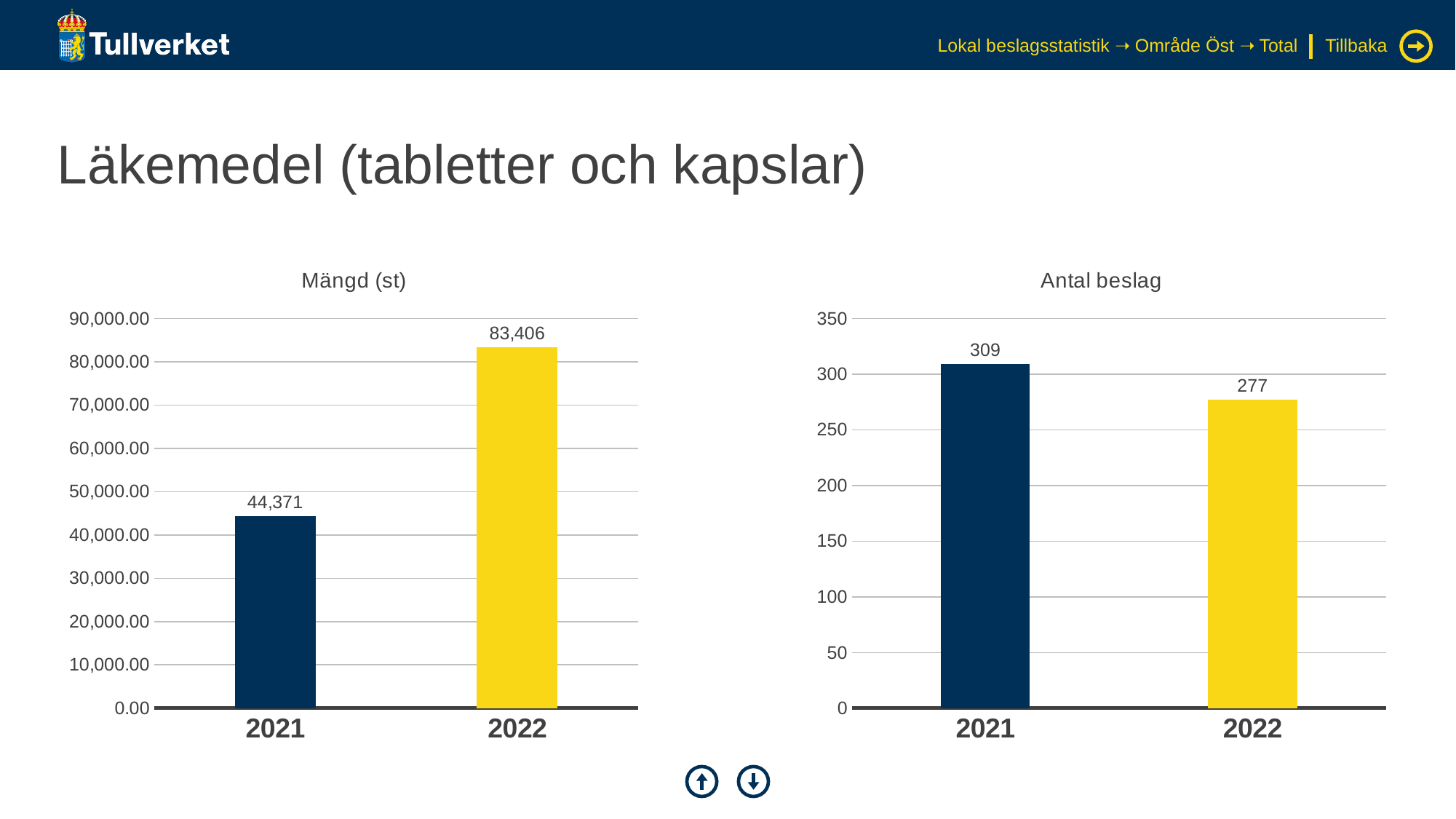
How many categories are shown in the 'Antal beslag' chart? 2 In the 'Mängd (st)' chart, what is the value for 2022? 83,406 In the 'Antal beslag' chart, is the value for 2021 greater or less than 300? greater In the 'Antal beslag' chart, which year has the lowest value? 2022 In the 'Mängd (st)' chart, what is the value for 2021? 44,371 In the 'Mängd (st)' chart, which year has the highest value? 2022 In the 'Antal beslag' chart, what is the difference between the 2021 and 2022 values? 32 In the 'Mängd (st)' chart, do the values rise or fall from 2021 to 2022? rise In the 'Mängd (st)' chart, what is the difference between the 2022 and 2021 values? 39,035 In the 'Antal beslag' chart, what is the value for 2022? 277 In the 'Antal beslag' chart, what is the value for 2021? 309 What kind of chart is the 'Mängd (st)' chart? bar chart